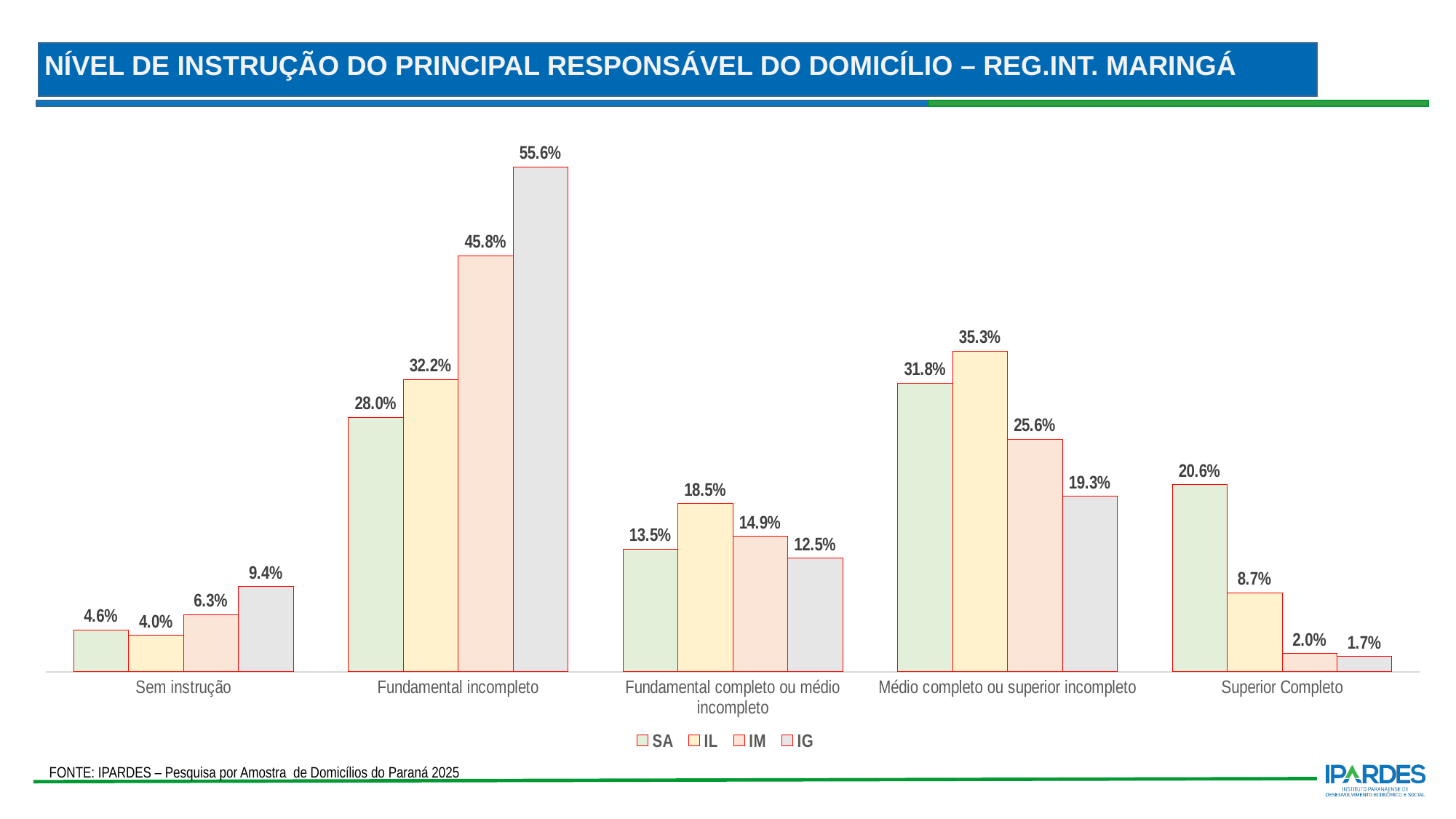
What kind of chart is shown on the slide? Bar chart What is the value for IL in the 'Médio completo ou superior incompleto' category? 35.3% How many series does the legend list? 4 What is the difference between the IG and SA values in the 'Fundamental incompleto' category? 27.6% What is the value for SA in the 'Superior Completo' category? 20.6% Which is larger in the 'Fundamental completo ou médio incompleto' category: IL or IM? IL Which series has the lowest value in the 'Superior Completo' category? IG What is the value for IG in the 'Fundamental incompleto' category? 55.6% Which series has the highest value in the 'Sem instrução' category? IG How many categories are shown on the x axis? 5 What is the difference between the IL and IM values in the 'Superior Completo' category? 6.7% What is the source cited at the bottom of the slide? IPARDES – Pesquisa por Amostra de Domicílios do Paraná 2025